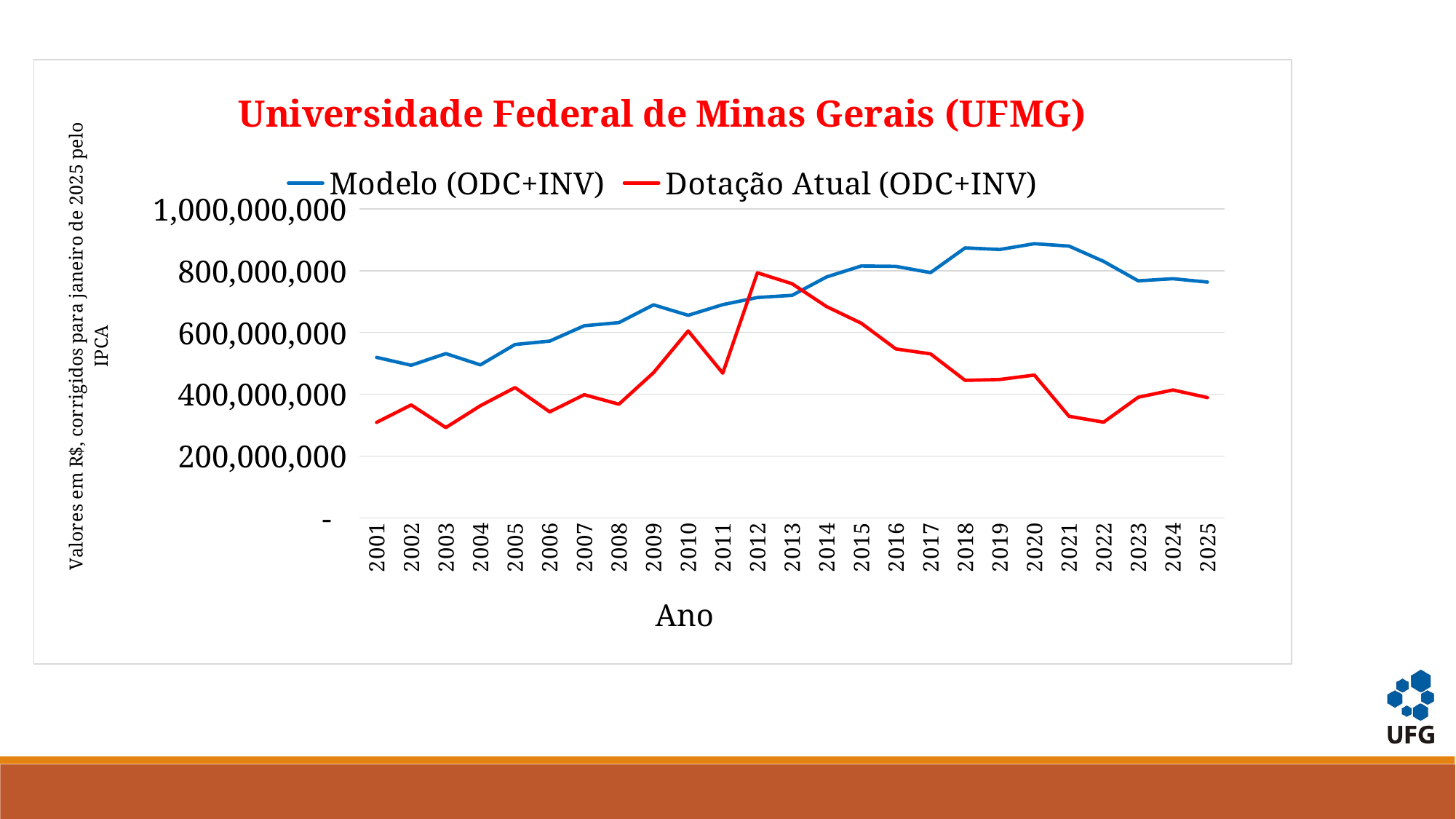
What is the title of the chart? Universidade Federal de Minas Gerais (UFMG) How many years are plotted along the x axis? 25 In which year does the Dotação Atual (ODC+INV) series reach its highest value? 2012 Does the Dotação Atual (ODC+INV) series generally rise or fall between 2012 and 2022? fall How many series does the legend list? 2 Is the value for Modelo (ODC+INV) in 2020 greater or less than 800,000,000? greater Which colour is used for the Dotação Atual (ODC+INV) series? red Is the value for Dotação Atual (ODC+INV) in 2012 greater or less than 600,000,000? greater What kind of chart is shown on the slide? line chart Is the value for Modelo (ODC+INV) in 2001 greater or less than 400,000,000? greater In 2025, which series has the higher value, Modelo (ODC+INV) or Dotação Atual (ODC+INV)? Modelo (ODC+INV)